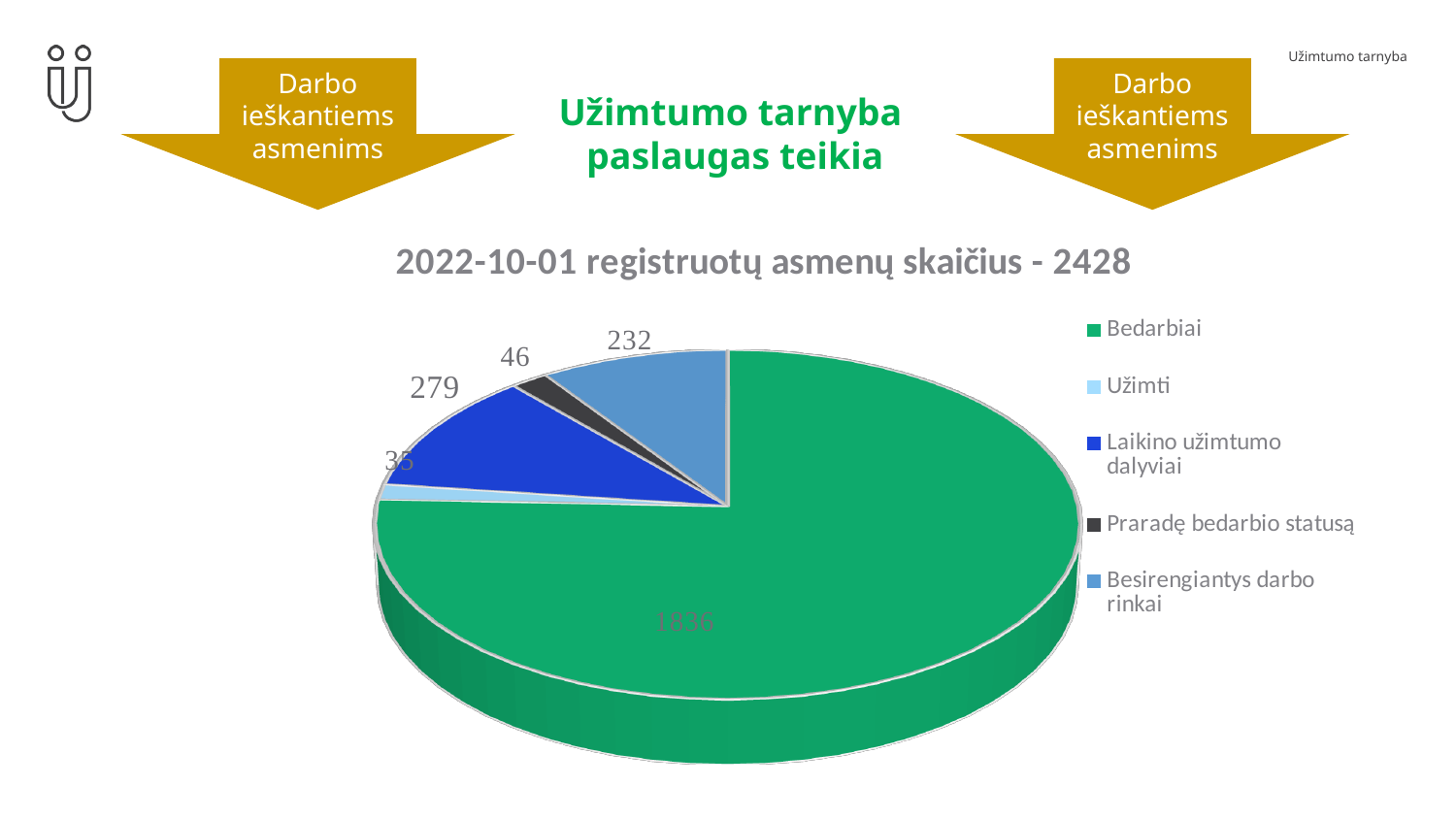
What is the value for Laikino užimtumo dalyviai in the pie chart? 279 Which is larger: the value for Praradę bedarbio statusą or the value for Besirengiantys darbo rinkai? Besirengiantys darbo rinkai Which category has the largest slice in the pie chart? Bedarbiai What is the difference between the values for Laikino užimtumo dalyviai and Besirengiantys darbo rinkai? 47 What is the total number of registered persons stated in the chart heading? 2428 How many categories does the pie chart have? 5 What is the value for Praradę bedarbio statusą in the pie chart? 46 What colour is the Bedarbiai slice in the pie chart? green What is the value for Bedarbiai in the pie chart? 1836 Which category has the smallest slice in the pie chart? Užimti What is the value for Besirengiantys darbo rinkai in the pie chart? 232 What kind of chart is shown on the slide? pie chart